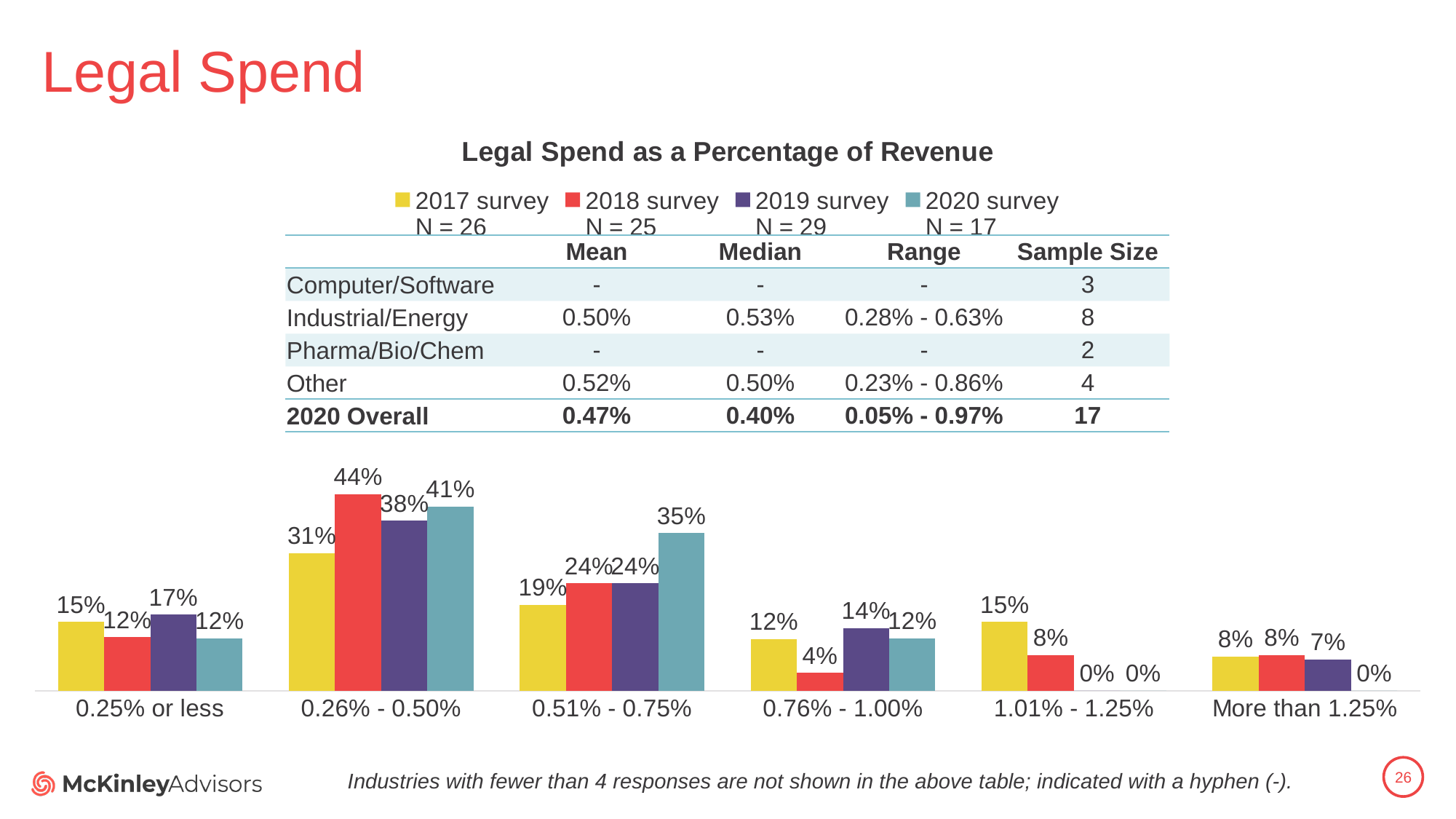
What is the value for the 2018 survey in the 0.26% - 0.50% category? 44% What is the value for the 2019 survey in the 0.25% or less category? 17% What kind of chart is shown on the slide? Bar chart How many categories are shown on the x axis of the chart? 6 What is the difference between the 2018 survey and 2017 survey values in the 0.26% - 0.50% category? 13% Which category has the lowest value for the 2020 survey? 1.01% - 1.25% and More than 1.25% (both 0%) What is the value for the 2018 survey in the 0.76% - 1.00% category? 4% In the 0.51% - 0.75% category, which is larger: the 2020 survey value or the 2017 survey value? 2020 survey Which category has the highest value for the 2017 survey? 0.26% - 0.50% What is the title of the chart? Legal Spend as a Percentage of Revenue How many series does the chart legend list? 4 What is the value for the 2020 survey in the 0.51% - 0.75% category? 35%